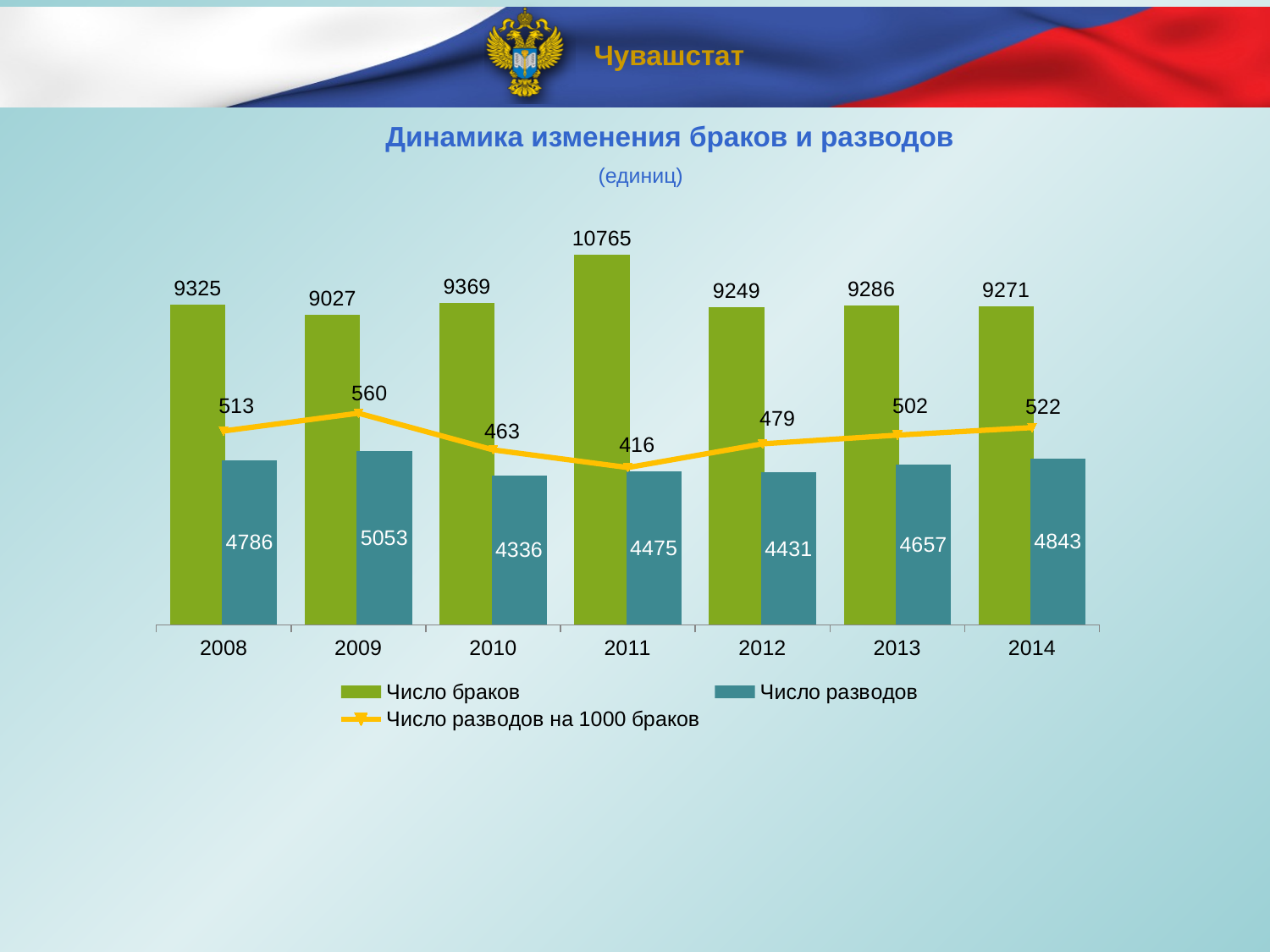
What is the difference between Число браков in 2011 and in 2010? 1396 What is the title of the chart? Динамика изменения браков и разводов What is the value of Число браков in 2011? 10765 What is the value of Число разводов in 2010? 4336 Which is larger: Число разводов in 2013 or in 2014? 2014 How many series does the legend list? 3 In which year is Число браков highest? 2011 In which year is Число разводов на 1000 браков lowest? 2011 In which year is Число разводов highest? 2009 What kind of chart is used for Число браков and Число разводов? bar chart How many years are shown on the x axis? 7 What is the value of Число разводов на 1000 браков in 2009? 560